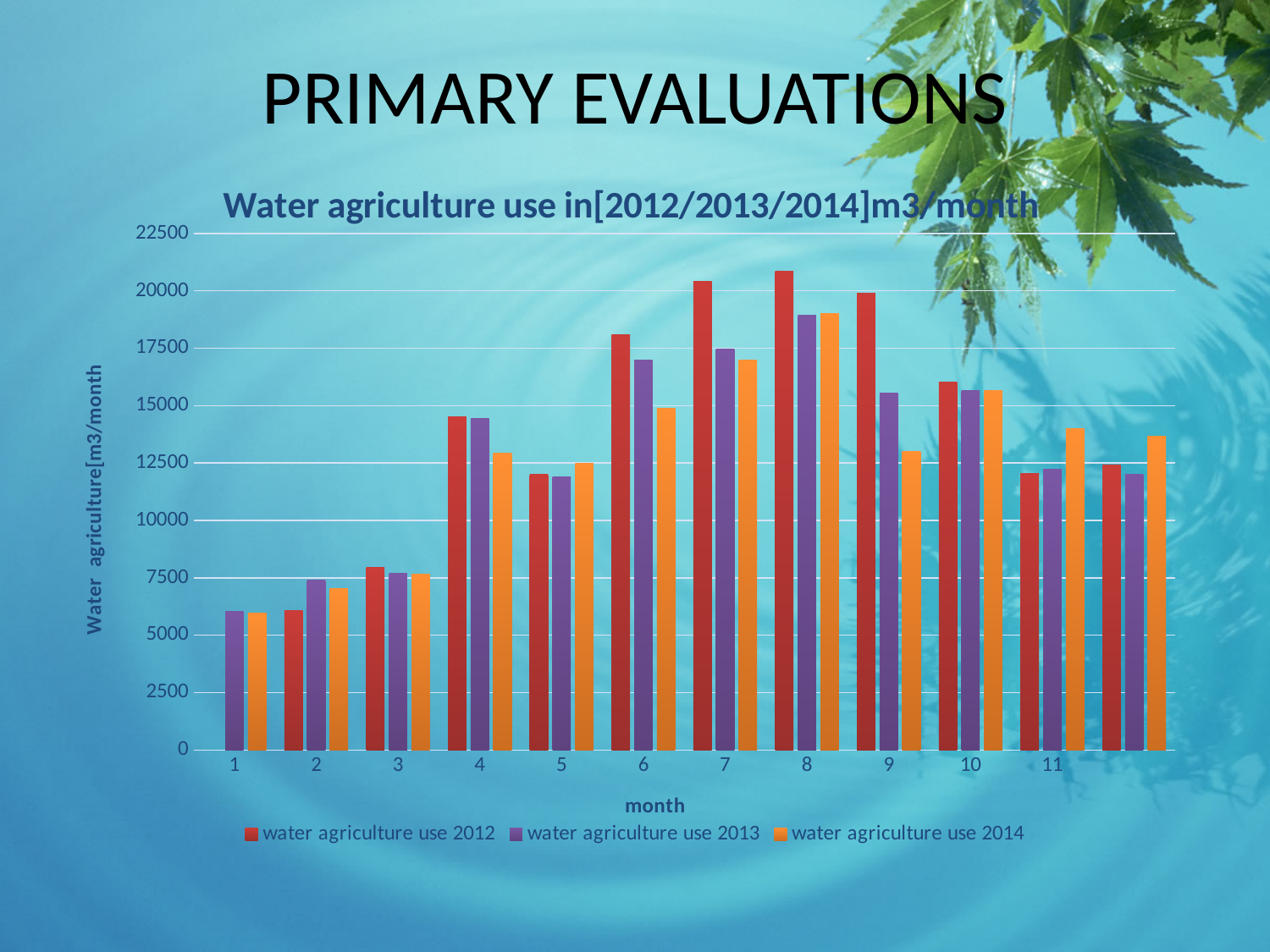
In month 11, which is larger: water agriculture use 2012 or water agriculture use 2014? water agriculture use 2014 In which month is the value for water agriculture use 2014 lowest? 1 In which month is the value for water agriculture use 2013 highest? 8 What is the title of the chart? Water agriculture use in[2012/2013/2014]m3/month How many series does the legend list? 3 Is the value for water agriculture use 2013 in month 4 greater or less than 15000? less Which colour represents the series 'water agriculture use 2014'? orange Is the value for water agriculture use 2012 in month 6 greater or less than 17500? greater In month 6, which is larger: water agriculture use 2012 or water agriculture use 2014? water agriculture use 2012 Do the values for water agriculture use 2013 rise or fall from month 1 to month 4? rise What kind of chart is shown on the slide? bar chart Is the value for water agriculture use 2014 in month 2 greater or less than 7500? less